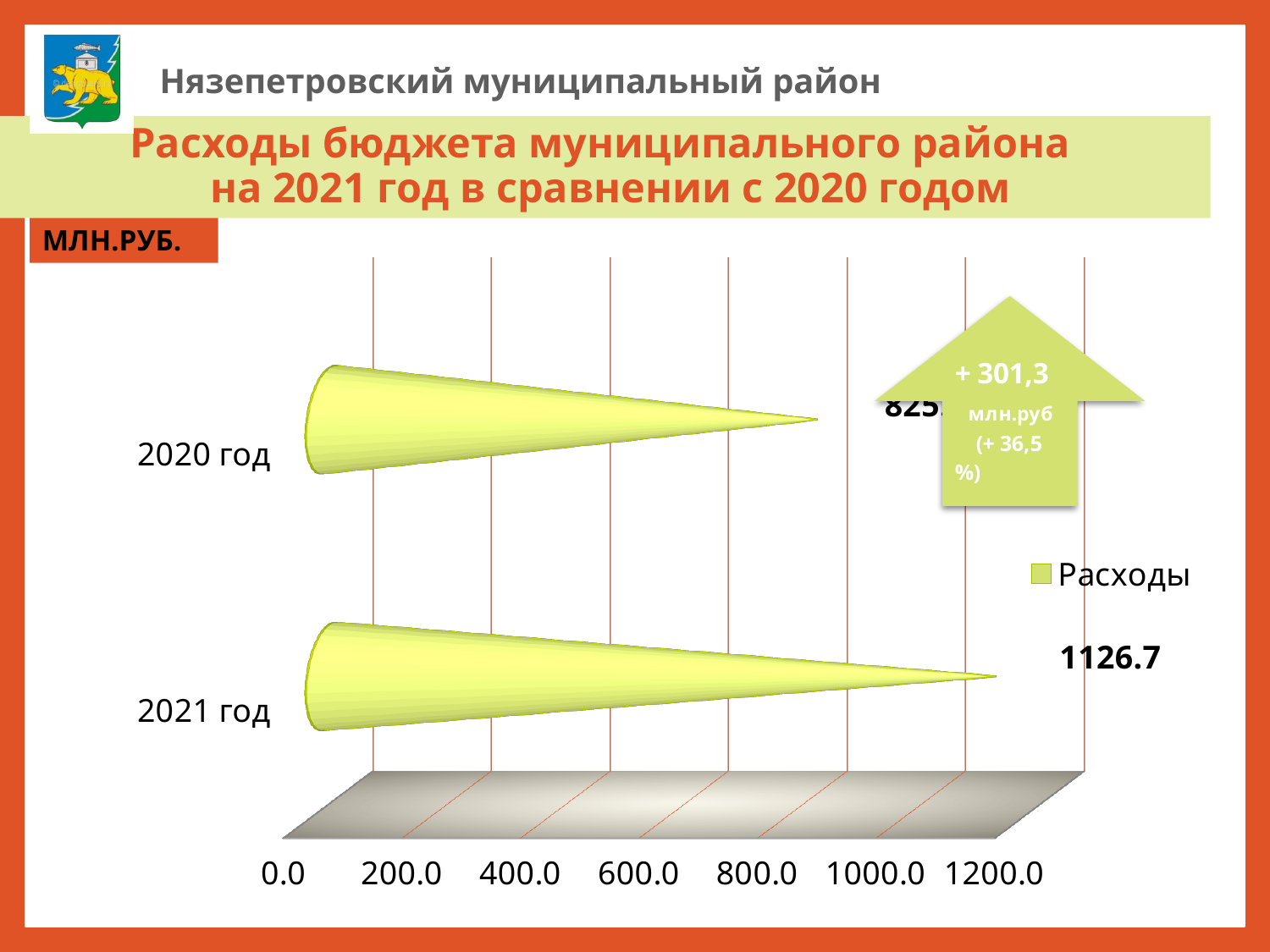
Is the value for 2020 год greater or less than 1000.0? less Is the value for 2020 год greater or less than 800.0? greater How many series does the legend list? 1 What is the value for 2021 год? 1126.7 What is the name of the series in the legend? Расходы Which year has the higher expenditure value? 2021 год How many categories (years) are shown in the chart? 2 What type of chart is shown on the slide? bar chart Which year has the lower expenditure value? 2020 год What unit of measurement is indicated for the chart values? МЛН.РУБ. Is the value for 2021 год greater or less than 1000.0? greater Which is larger, the value for 2020 год or the value for 2021 год? 2021 год